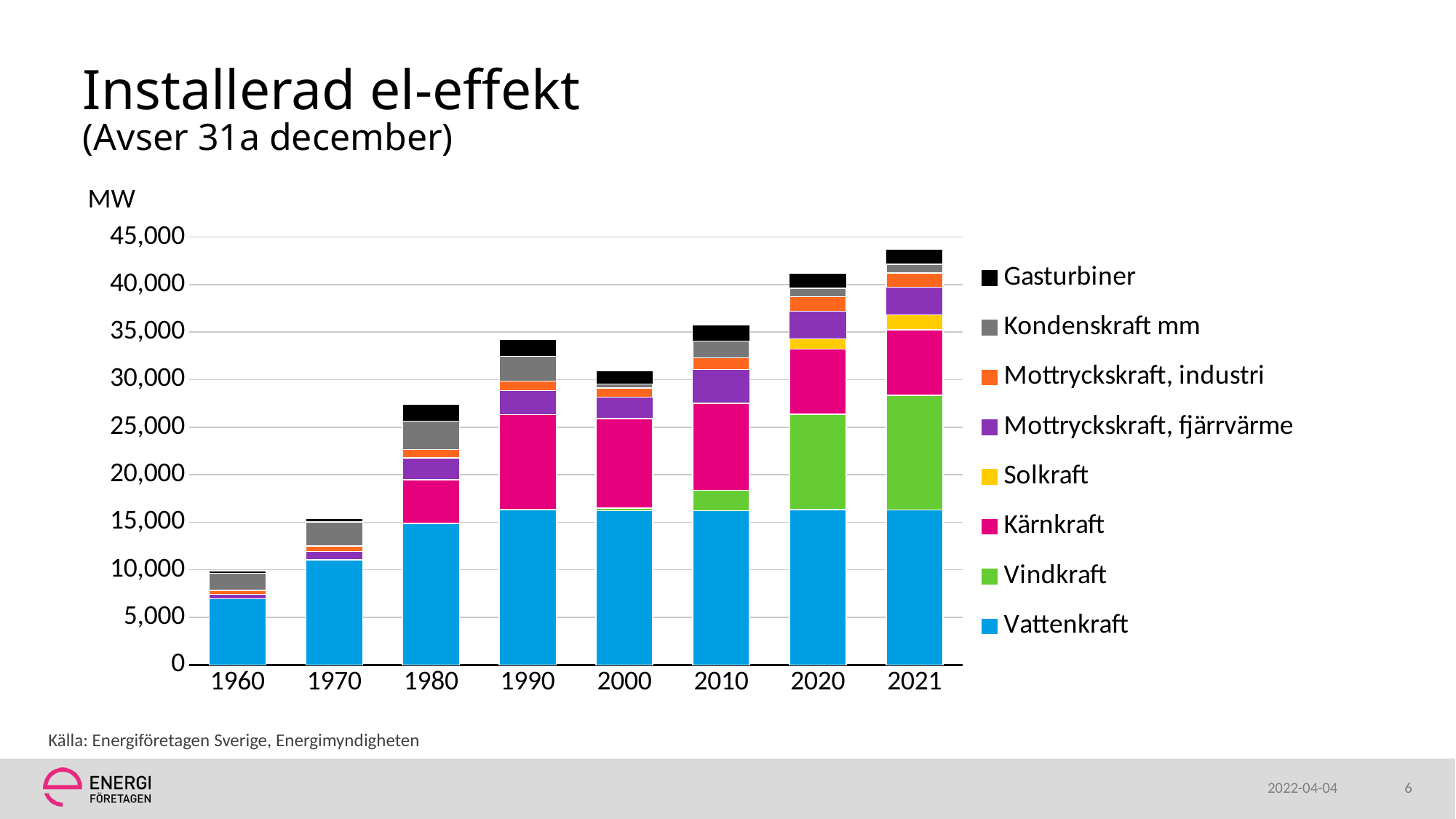
How many series does the legend list? 8 What kind of chart is shown on the slide? Stacked bar chart Is the total for 1990 greater or less than 35,000? less What unit is shown on the y axis? MW Which year has the highest total installed capacity? 2021 Which year has a larger total, 1990 or 2000? 1990 Is the total for 1980 greater or less than 25,000? greater Which year has the lowest total installed capacity? 1960 How many years (bars) are shown on the x axis? 8 Is the total for 2010 greater or less than 40,000? less Does the total installed capacity rise or fall from 1960 to 1990? rise